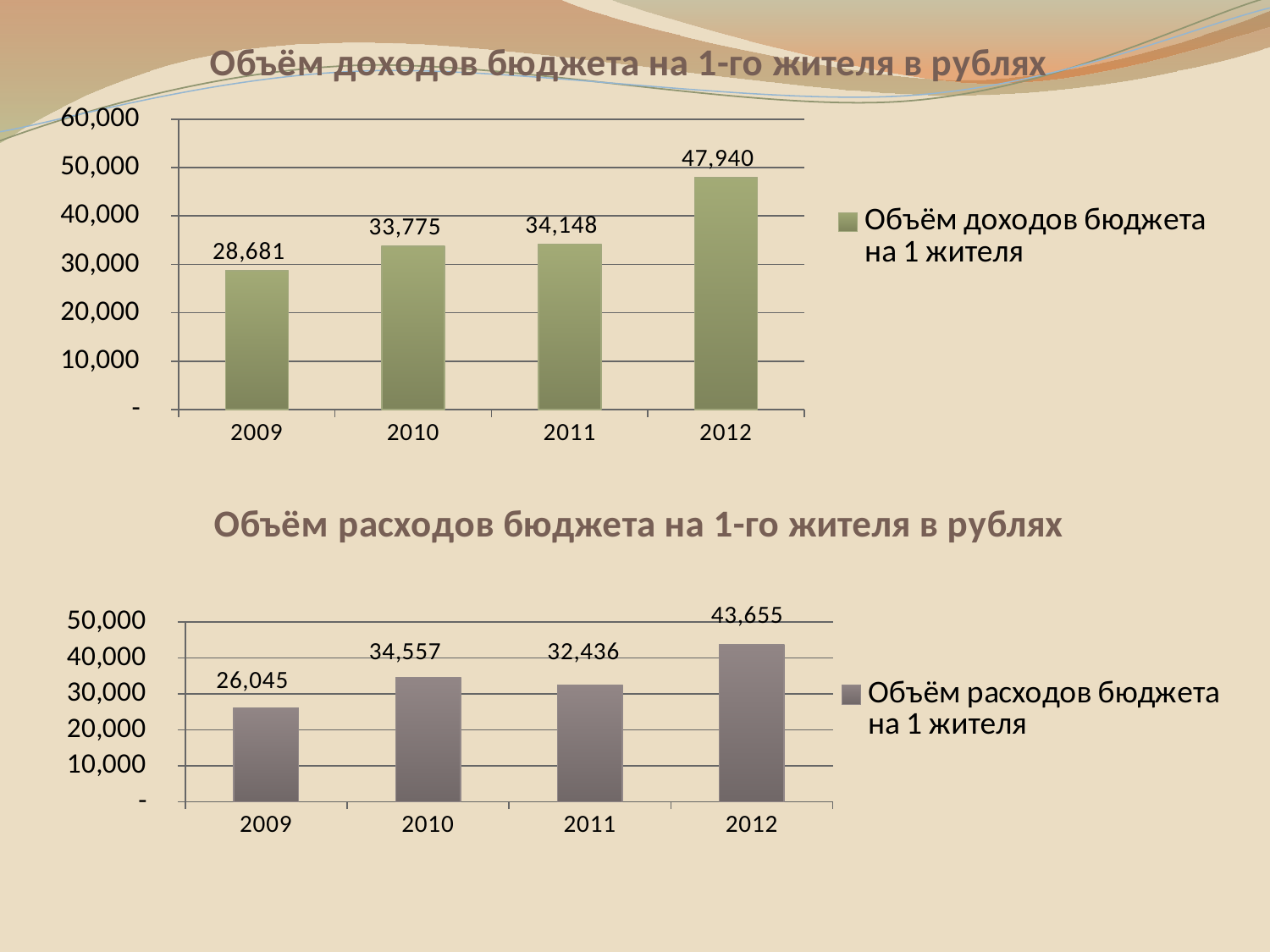
How many years are shown on the x axis of the top chart (Объём доходов бюджета на 1-го жителя в рублях)? 4 In the bottom chart (Объём расходов бюджета на 1-го жителя в рублях), what is the value for 2011? 32,436 In the bottom chart (Объём расходов бюджета на 1-го жителя в рублях), what is the difference between the values for 2010 and 2009? 8,512 In the top chart (Объём доходов бюджета на 1-го жителя в рублях), which year has the highest value? 2012 In the top chart (Объём доходов бюджета на 1-го жителя в рублях), what is the value for 2012? 47,940 What is the legend entry of the bottom chart (Объём расходов бюджета на 1-го жителя в рублях)? Объём расходов бюджета на 1 жителя In the top chart (Объём доходов бюджета на 1-го жителя в рублях), what is the value for 2009? 28,681 How many series does the legend of the top chart (Объём доходов бюджета на 1-го жителя в рублях) list? 1 In the bottom chart (Объём расходов бюджета на 1-го жителя в рублях), which is larger, the value for 2010 or the value for 2011? 2010 What kind of chart is the bottom chart (Объём расходов бюджета на 1-го жителя в рублях)? bar chart In the top chart (Объём доходов бюджета на 1-го жителя в рублях), what is the difference between the values for 2012 and 2011? 13,792 In the bottom chart (Объём расходов бюджета на 1-го жителя в рублях), which year has the lowest value? 2009